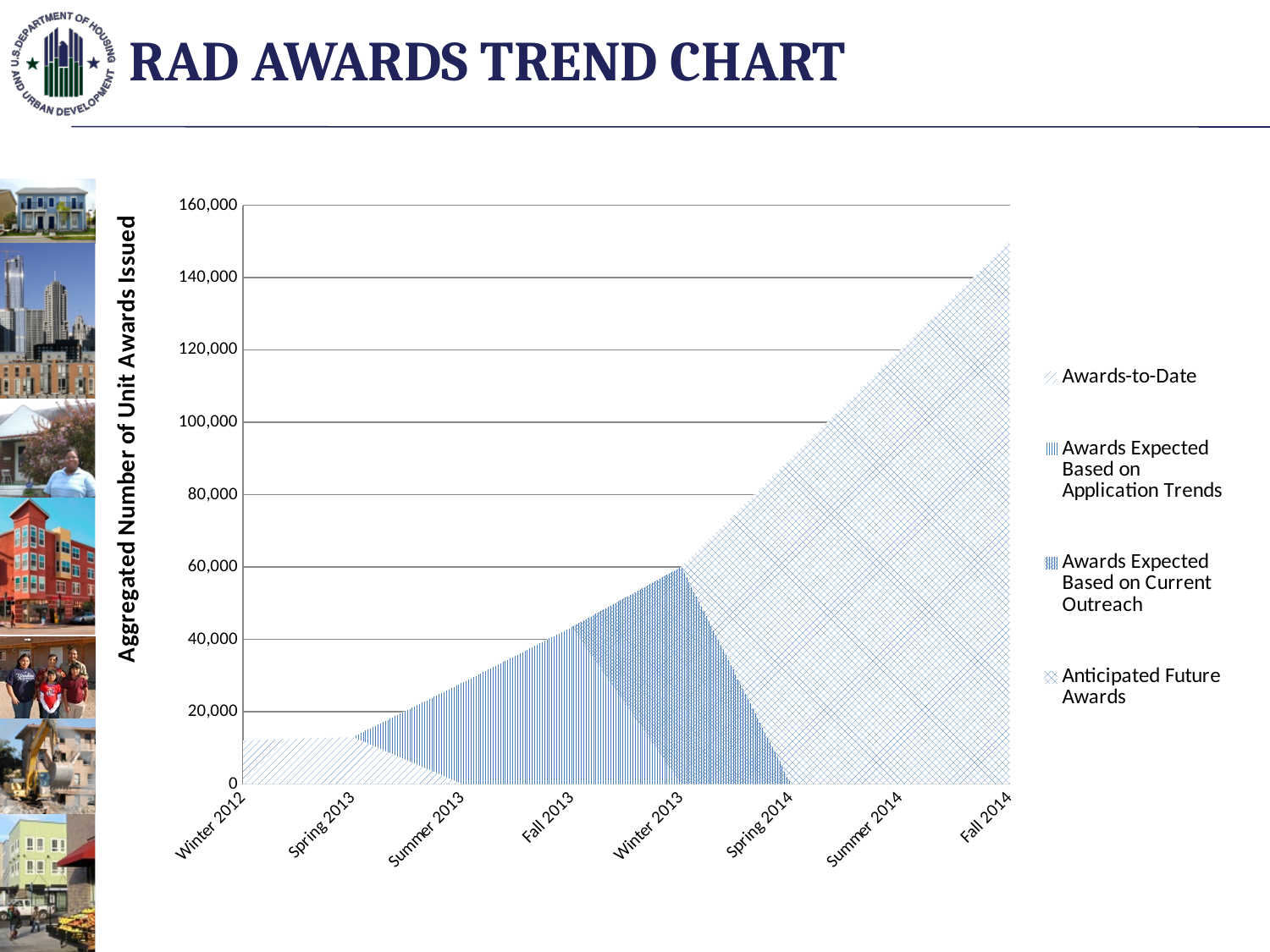
Which period has the highest aggregated number of unit awards issued? Fall 2014 Is the total value for Summer 2014 greater or less than 100,000? greater Is the total value for Winter 2012 greater or less than 20,000? less How many time periods are shown along the x axis of the chart? 8 Do the aggregated unit awards rise or fall from Winter 2012 to Fall 2014? Rise Is the total value for Fall 2014 greater or less than 140,000? greater Which period has a larger total value, Summer 2014 or Spring 2014? Summer 2014 What kind of chart is shown on the slide? Area chart What is the title of the chart's y axis? Aggregated Number of Unit Awards Issued How many series does the chart's legend list? 4 What is the last series listed in the chart's legend? Anticipated Future Awards